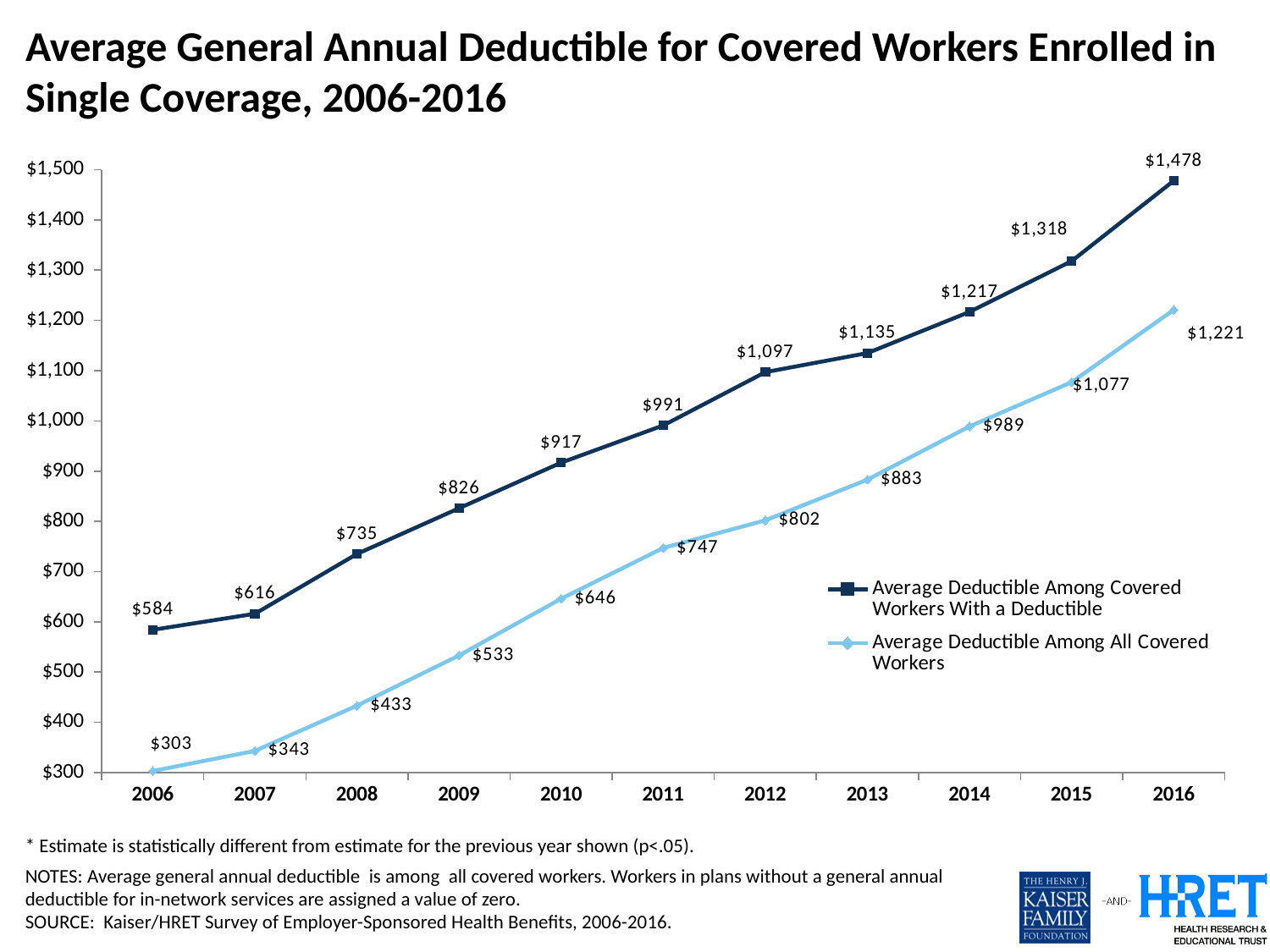
What is the average deductible among all covered workers in 2012? $802 What is the average deductible among covered workers with a deductible in 2010? $917 What is the average deductible among all covered workers in 2006? $303 In which year is the average deductible among all covered workers the highest? 2016 Which is larger in 2013: the average deductible among covered workers with a deductible or among all covered workers? Average Deductible Among Covered Workers With a Deductible How many years are shown on the x axis? 11 In which year is the average deductible among covered workers with a deductible the lowest? 2006 What is the difference between the two series in 2016? $257 How many series does the legend list? 2 By how much did the average deductible among all covered workers increase from 2006 to 2016? $918 What kind of chart is shown on the slide? Line chart What is the average deductible among covered workers with a deductible in 2016? $1,478